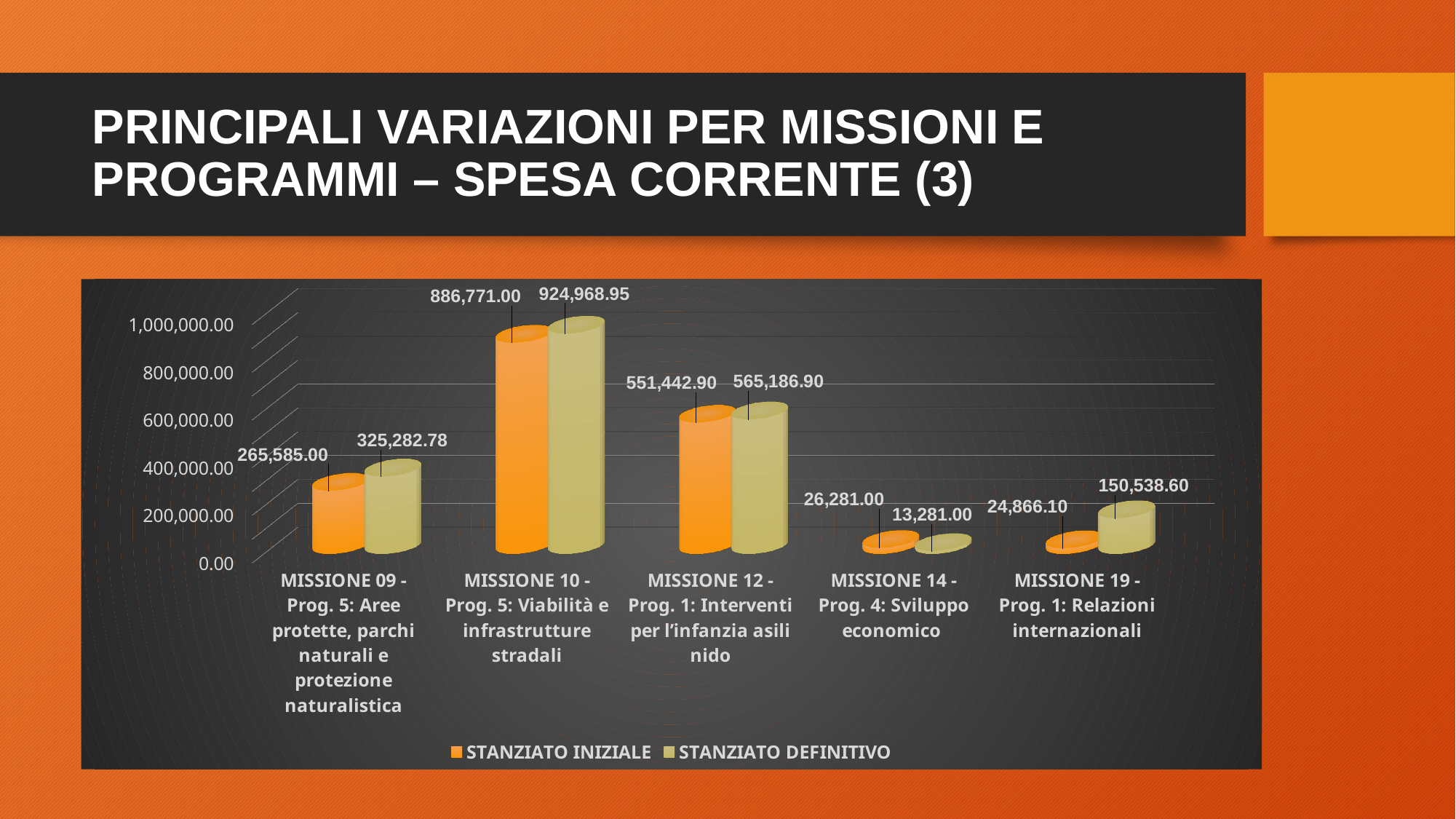
For MISSIONE 14 - Prog. 4: Sviluppo economico, which is larger: STANZIATO INIZIALE or STANZIATO DEFINITIVO? STANZIATO INIZIALE What is the STANZIATO DEFINITIVO value for MISSIONE 09 - Prog. 5: Aree protette, parchi naturali e protezione naturalistica? 325,282.78 How many series does the legend list? 2 What kind of chart is shown on the slide? Bar chart Is the STANZIATO DEFINITIVO value for MISSIONE 12 - Prog. 1: Interventi per l'infanzia asili nido greater or less than 400,000.00? greater How many missions (categories) are shown on the chart? 5 What is the difference between STANZIATO INIZIALE and STANZIATO DEFINITIVO for MISSIONE 14 - Prog. 4: Sviluppo economico? 13,000.00 What is the difference between STANZIATO DEFINITIVO and STANZIATO INIZIALE for MISSIONE 10 - Prog. 5: Viabilità e infrastrutture stradali? 38,197.95 Which mission has the highest STANZIATO DEFINITIVO value? MISSIONE 10 - Prog. 5: Viabilità e infrastrutture stradali What is the STANZIATO INIZIALE value for MISSIONE 10 - Prog. 5: Viabilità e infrastrutture stradali? 886,771.00 What is the STANZIATO DEFINITIVO value for MISSIONE 19 - Prog. 1: Relazioni internazionali? 150,538.60 Which mission has the lowest STANZIATO INIZIALE value? MISSIONE 19 - Prog. 1: Relazioni internazionali